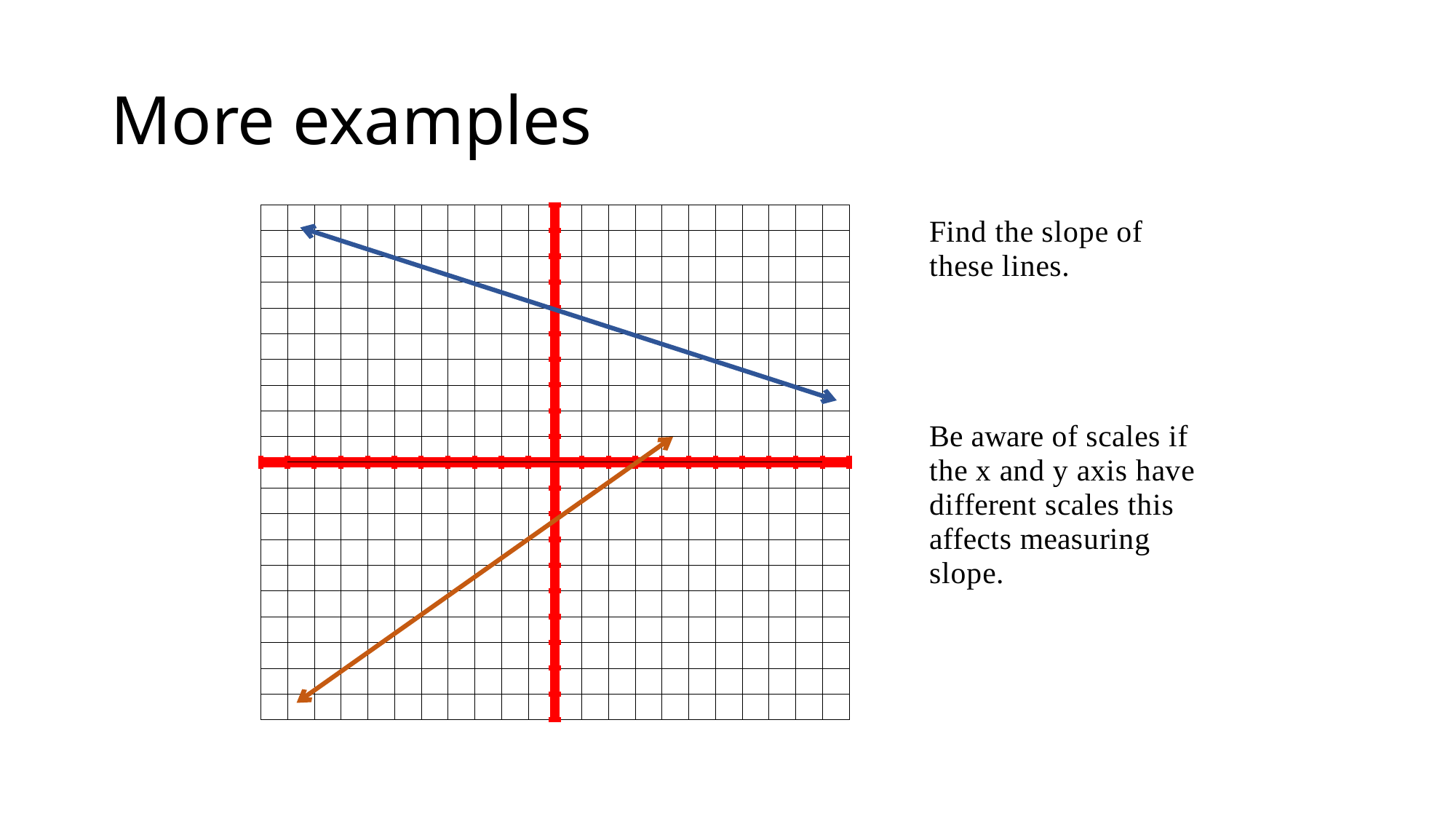
Does the orange line rise or fall as you move from left to right along the x axis? rise Which line is steeper, the blue line or the orange line? orange Which line has a positive slope, the blue line or the orange line? orange What colour are the x and y axes drawn in? red Does the blue line rise or fall as you move from left to right along the x axis? fall How many lines are drawn on the grid? 2 Does the blue line cross the y axis above or below the x axis? above